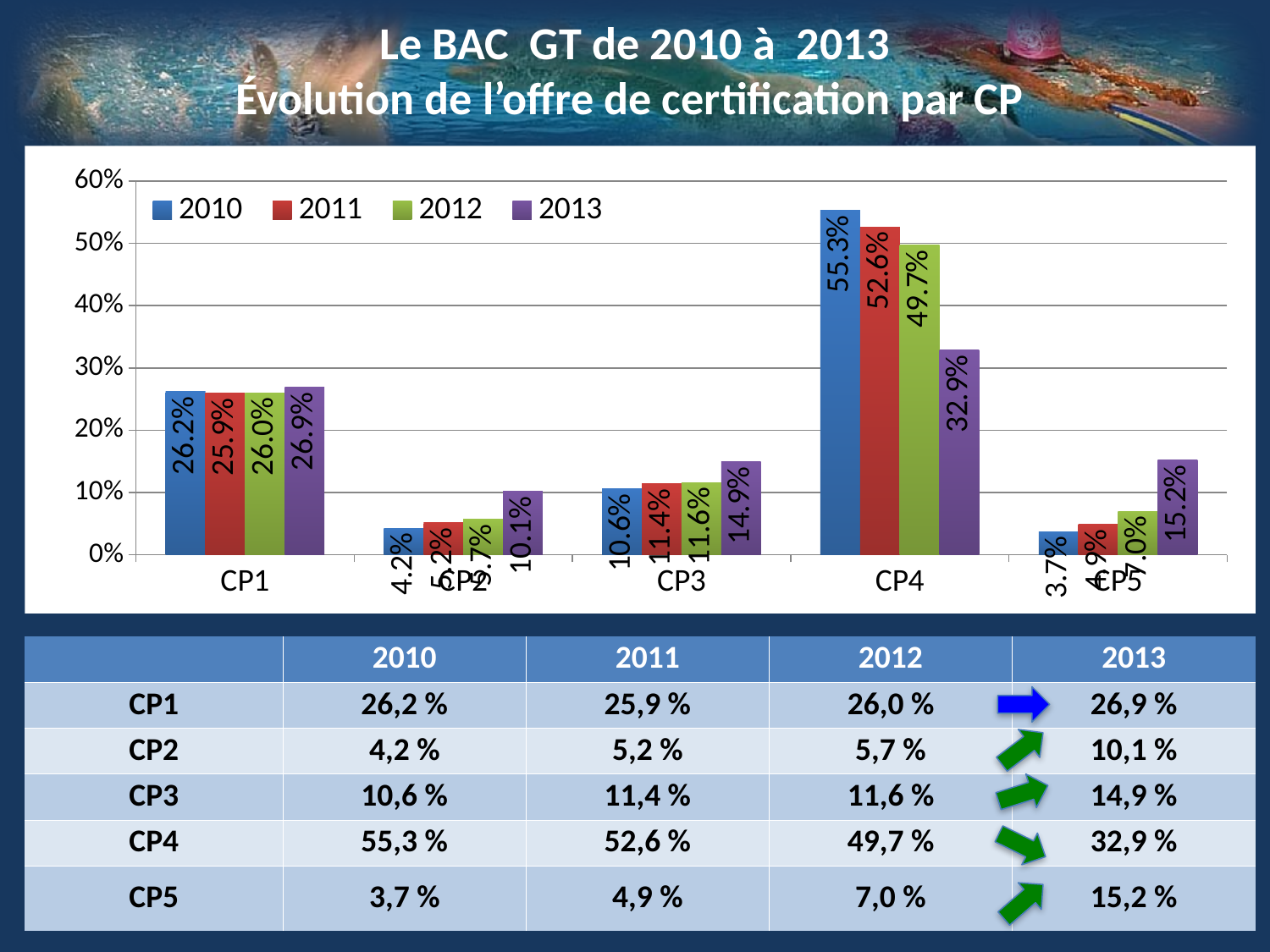
How many series does the legend list? 4 Which category has the highest value for 2012? CP4 What type of chart is shown on the slide? bar chart What is the difference between the 2010 and 2013 values for CP4? 22.4% Which is larger for 2013: CP2 or CP5? CP5 Do the values for CP5 rise or fall from 2010 to 2013? rise Which category has the lowest value for 2010? CP5 What is the value for CP4 in 2010? 55.3% What is the value for CP1 in 2013? 26.9% Which series is shown in purple in the legend? 2013 How many categories are shown on the x axis? 5 What is the value for CP3 in 2011? 11.4%